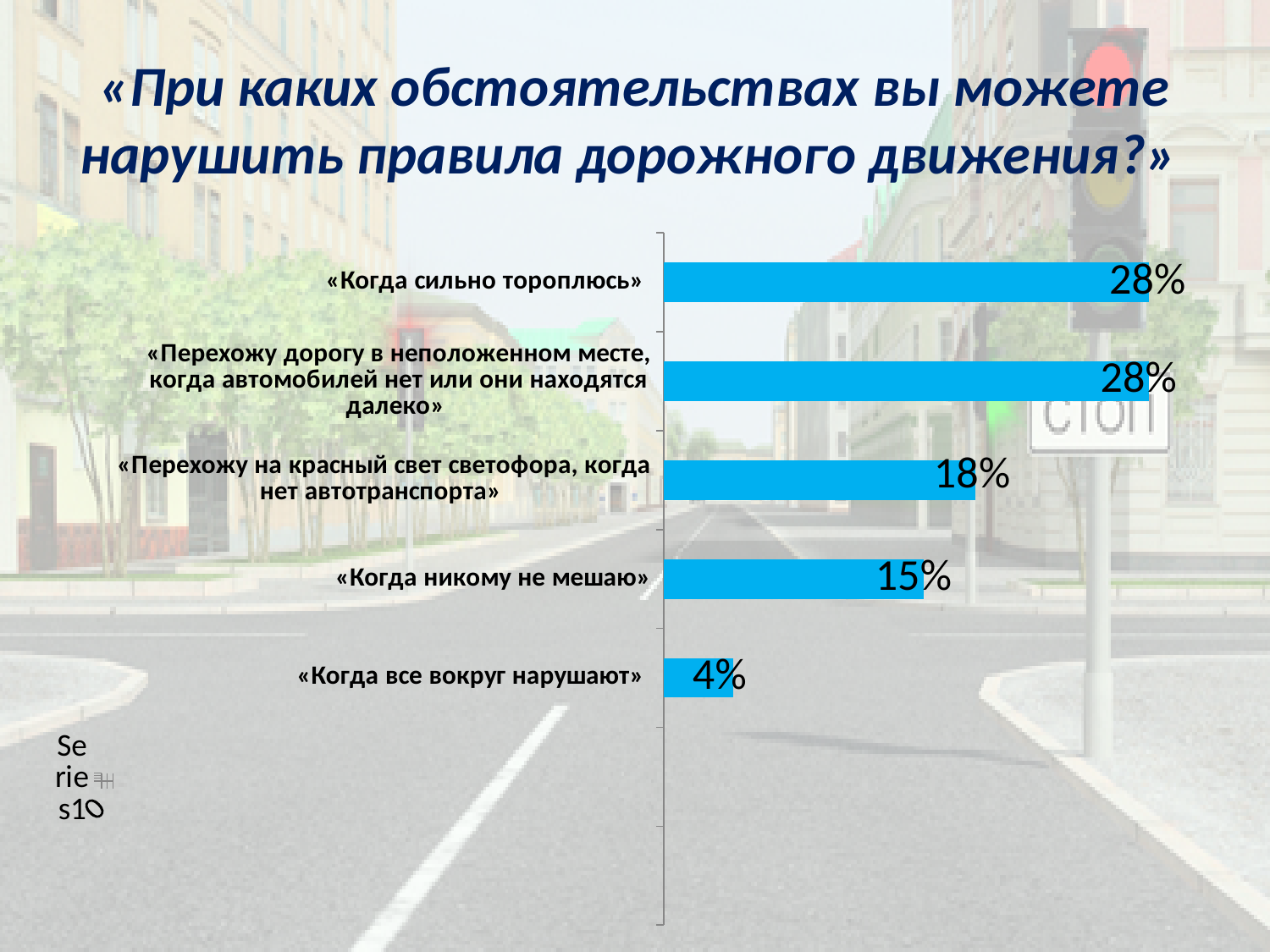
What is the difference between the values for «Когда сильно тороплюсь» and «Перехожу на красный свет светофора, когда нет автотранспорта»? 10% What kind of chart is shown on the slide? Bar chart Which is larger: the value for «Перехожу на красный свет светофора, когда нет автотранспорта» or for «Когда никому не мешаю»? «Перехожу на красный свет светофора, когда нет автотранспорта» What is the title of the slide? «При каких обстоятельствах вы можете нарушить правила дорожного движения?» What is the value for «Перехожу дорогу в неположенном месте, когда автомобилей нет или они находятся далеко»? 28% What is the value for «Когда никому не мешаю»? 15% Which category has the lowest value? «Когда все вокруг нарушают» How many categories are shown in the chart? 5 What is the value for «Когда сильно тороплюсь»? 28% What is the value for «Перехожу на красный свет светофора, когда нет автотранспорта»? 18% What is the value for «Когда все вокруг нарушают»? 4% What is the difference between the values for «Когда никому не мешаю» and «Когда все вокруг нарушают»? 11%